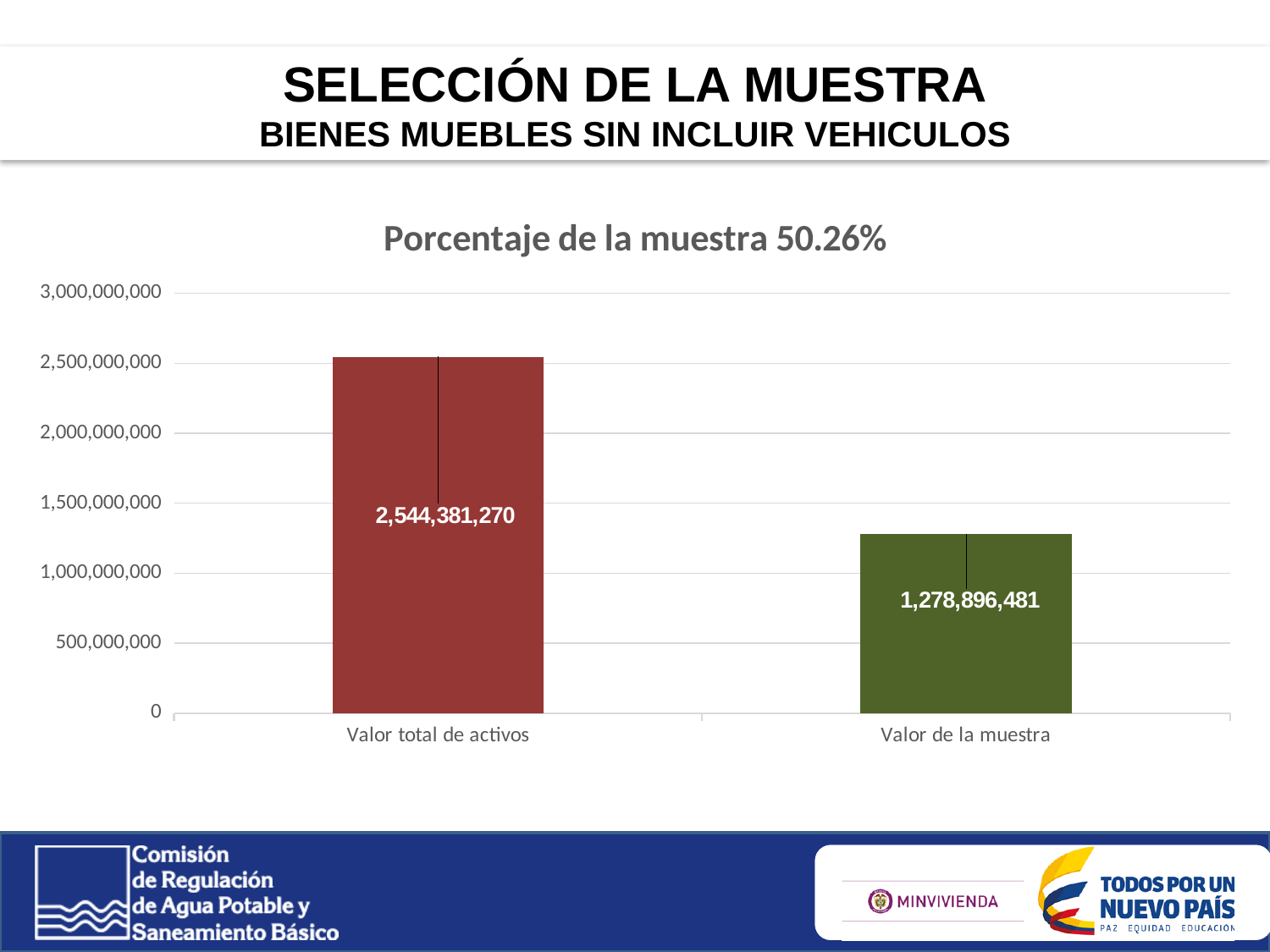
What is the difference between Valor total de activos and Valor de la muestra? 1,265,484,789 What is the value for Valor total de activos? 2,544,381,270 Which category has the lowest value? Valor de la muestra What is the value for Valor de la muestra? 1,278,896,481 Is the value for Valor total de activos greater or less than 2,000,000,000? greater What kind of chart is shown on the slide? bar chart Is the value for Valor de la muestra greater or less than 1,500,000,000? less What is the title of the chart? Porcentaje de la muestra 50.26% Which is larger, Valor total de activos or Valor de la muestra? Valor total de activos How many categories are shown on the x axis? 2 Which category has the highest value? Valor total de activos What colour is the bar for Valor de la muestra? green